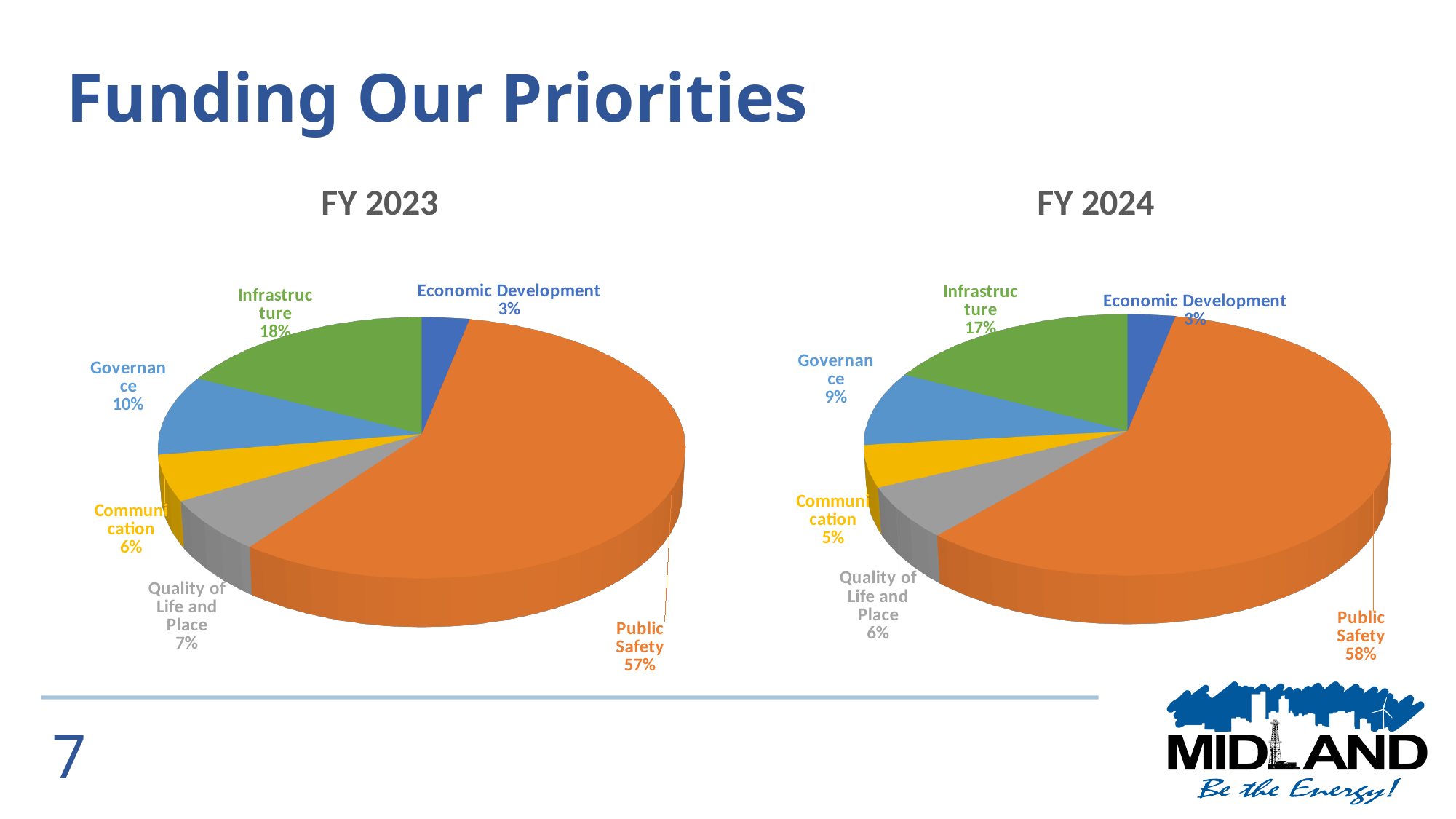
What kind of chart is the FY 2023 chart? Pie chart In the FY 2023 chart, which category has the smallest share? Economic Development In the FY 2024 chart, what share does Communication have? 5% In the FY 2023 chart, which is larger: Infrastructure or Governance? Infrastructure In the FY 2023 chart, what is the combined share of Quality of Life and Place and Communication? 13% In the FY 2023 chart, what share does Public Safety have? 57% What is the title of the chart on the right side of the slide? FY 2024 In the FY 2023 chart, what share does Governance have? 10% In the FY 2024 chart, what share does Infrastructure have? 17% How many categories are shown in the FY 2024 chart? 6 In the FY 2024 chart, which category has the largest share? Public Safety What is the difference between the Public Safety share in FY 2024 and in FY 2023? 1%